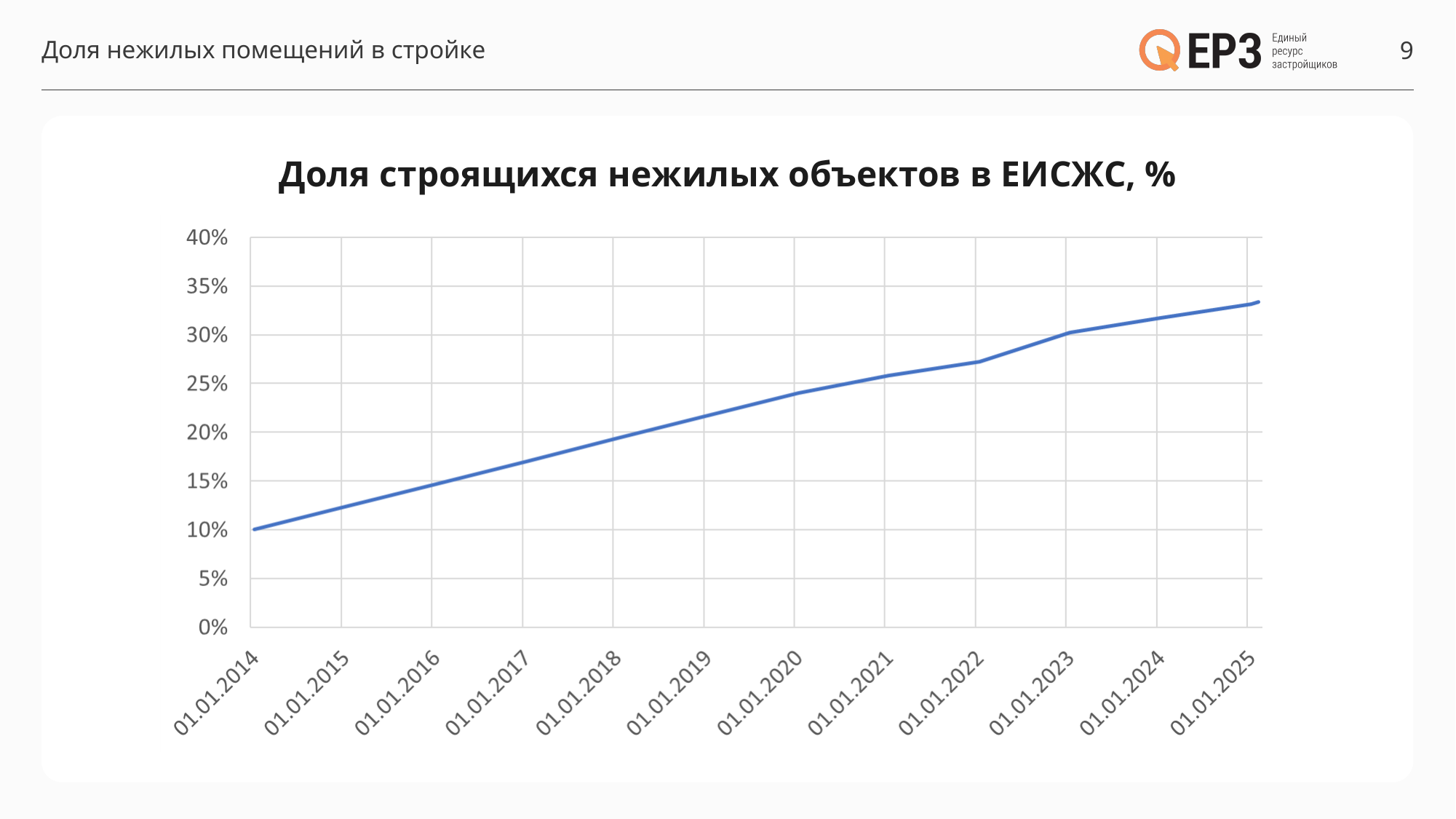
Is the value for 01.01.2025 greater or less than 30%? greater Is the value for 01.01.2018 greater or less than 20%? less Which is larger, the value for 01.01.2016 or the value for 01.01.2021? 01.01.2021 What is the title of the chart? Доля строящихся нежилых объектов в ЕИСЖС, % What is the share on 01.01.2014? 10% What kind of chart is shown on the slide? line chart How many dates are shown on the x axis of the chart? 12 Do the values rise or fall from 01.01.2014 to 01.01.2025? rise Is the value for 01.01.2022 greater or less than 25%? greater On which date is the share lowest? 01.01.2014